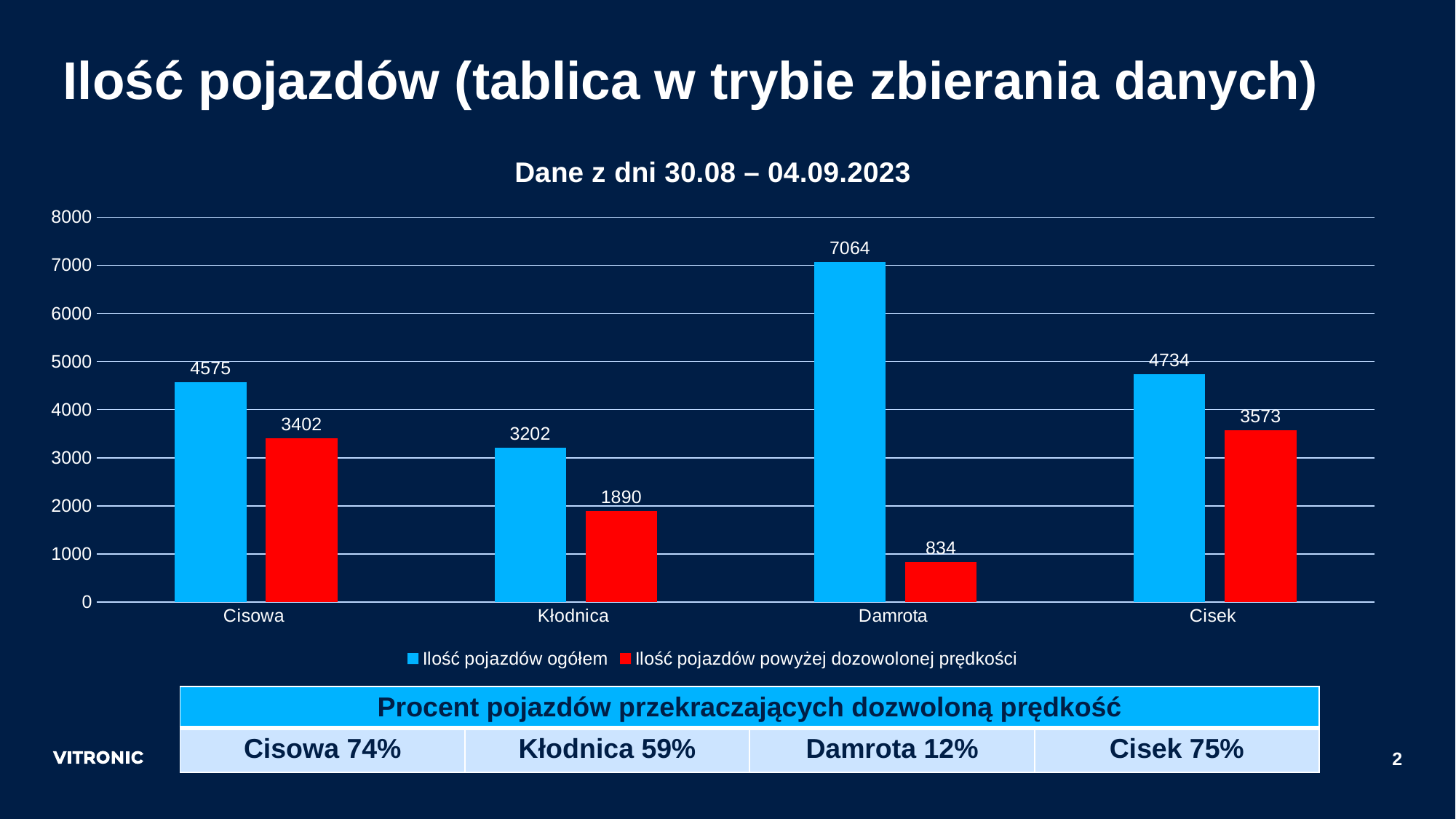
How many series does the chart legend list? 2 What colour are the bars for 'Ilość pojazdów powyżej dozowolonej prędkości'? red What is the value of 'Ilość pojazdów powyżej dozowolonej prędkości' for Kłodnica? 1890 Which location has the lowest 'Ilość pojazdów powyżej dozowolonej prędkości'? Damrota What kind of chart is shown on the slide? bar chart What is the difference in 'Ilość pojazdów ogółem' between Damrota and Kłodnica? 3862 What is the difference between 'Ilość pojazdów ogółem' and 'Ilość pojazdów powyżej dozowolonej prędkości' for Cisowa? 1173 Is the value of 'Ilość pojazdów ogółem' for Kłodnica greater or less than 4000? less How many locations are shown on the x axis of the chart? 4 Which location has the highest 'Ilość pojazdów ogółem'? Damrota Which is larger: 'Ilość pojazdów ogółem' for Cisek or for Cisowa? Cisek What is the value of 'Ilość pojazdów ogółem' for Damrota? 7064